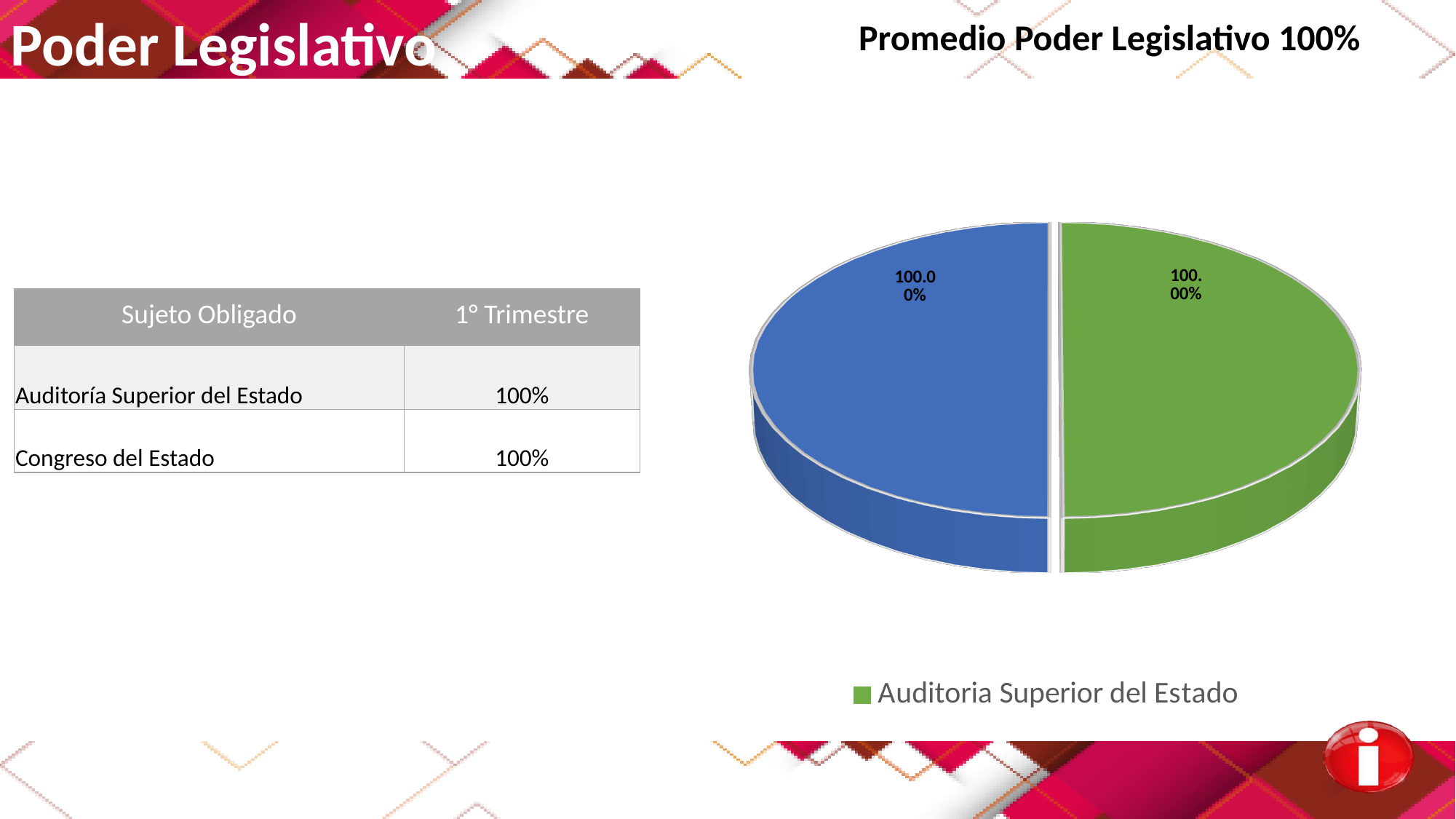
How many entries does the pie chart's legend list? 1 What kind of chart is shown on the slide? pie chart What value is printed on the green slice of the pie chart (Auditoria Superior del Estado)? 100.00% What heading appears above the pie chart? Promedio Poder Legislativo 100% Which entry is listed in the pie chart's legend? Auditoria Superior del Estado What value is printed on the blue slice of the pie chart? 100.00% How many slices does the pie chart have? 2